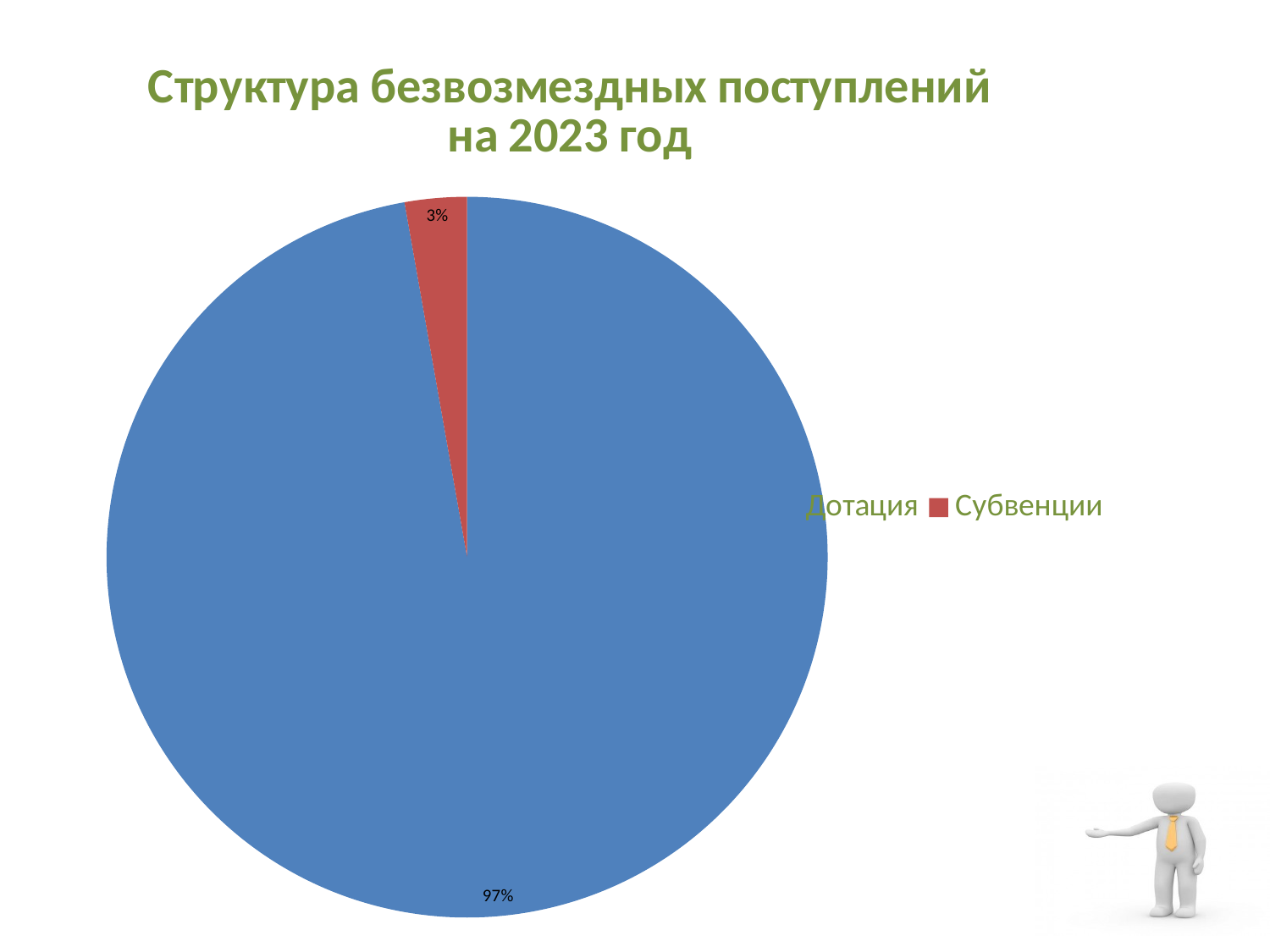
What is the difference in percentage points between the Дотация share and the Субвенции share? 94 Which category has the smallest slice of the pie? Субвенции Which is larger, the share for Дотация or the share for Субвенции? Дотация What colour is the slice for Субвенции? red What share of the pie does Дотация have? 97% What share of the pie does Субвенции have? 3% How many entries does the legend list? 2 What kind of chart is shown on the slide? pie chart Which category has the largest slice of the pie? Дотация How many categories does the pie chart show? 2 What is the title of the chart? Структура безвозмездных поступлений на 2023 год